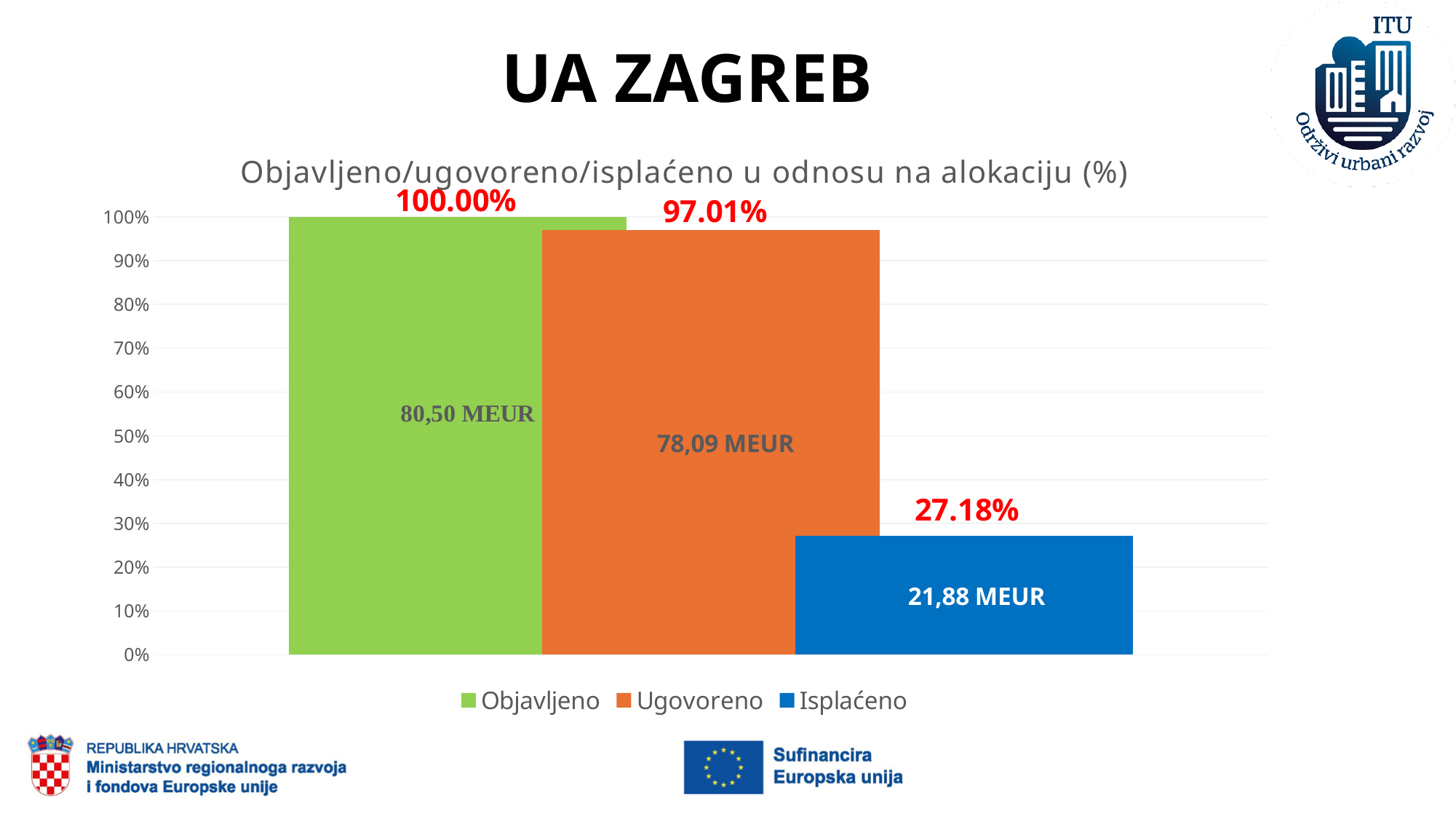
What percentage value is shown for Objavljeno? 100.00% Which is larger, the percentage for Ugovoreno or for Isplaćeno? Ugovoreno Which series has the highest percentage value? Objavljeno What is the title of the chart? Objavljeno/ugovoreno/isplaćeno u odnosu na alokaciju (%) What kind of chart is shown on the slide? Bar chart What is the difference in percentage points between Objavljeno and Isplaćeno? 72.82% How many series does the legend list? 3 What amount in MEUR is labelled on the Ugovoreno bar? 78,09 MEUR What percentage value is shown for Isplaćeno? 27.18% Which series has the lowest percentage value? Isplaćeno What amount in MEUR is labelled on the Isplaćeno bar? 21,88 MEUR What percentage value is shown for Ugovoreno? 97.01%